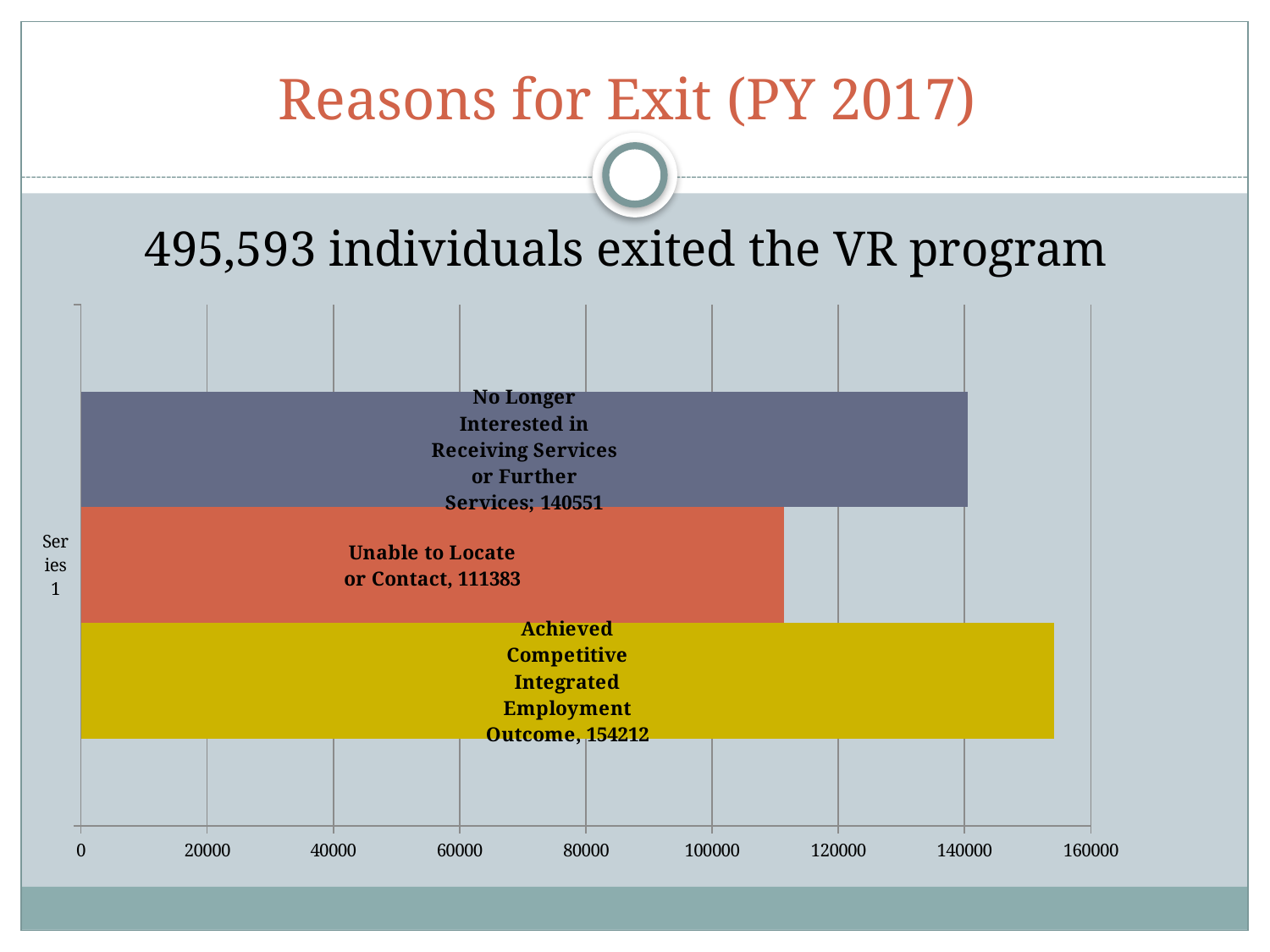
How many bars are plotted in the chart? 3 Is the value for Unable to Locate or Contact greater or less than 120000? less What is the value for No Longer Interested in Receiving Services or Further Services? 140551 Which reason for exit has the lowest value? Unable to Locate or Contact What is the difference between the values for Achieved Competitive Integrated Employment Outcome and Unable to Locate or Contact? 42829 What is the value for Achieved Competitive Integrated Employment Outcome? 154212 What is the difference between the values for No Longer Interested in Receiving Services or Further Services and Unable to Locate or Contact? 29168 What is the title of the slide containing the chart? Reasons for Exit (PY 2017) Which reason for exit has the highest value? Achieved Competitive Integrated Employment Outcome What kind of chart is shown on the slide? bar chart What is the value for Unable to Locate or Contact? 111383 Which is larger: the value for No Longer Interested in Receiving Services or Further Services or the value for Unable to Locate or Contact? No Longer Interested in Receiving Services or Further Services